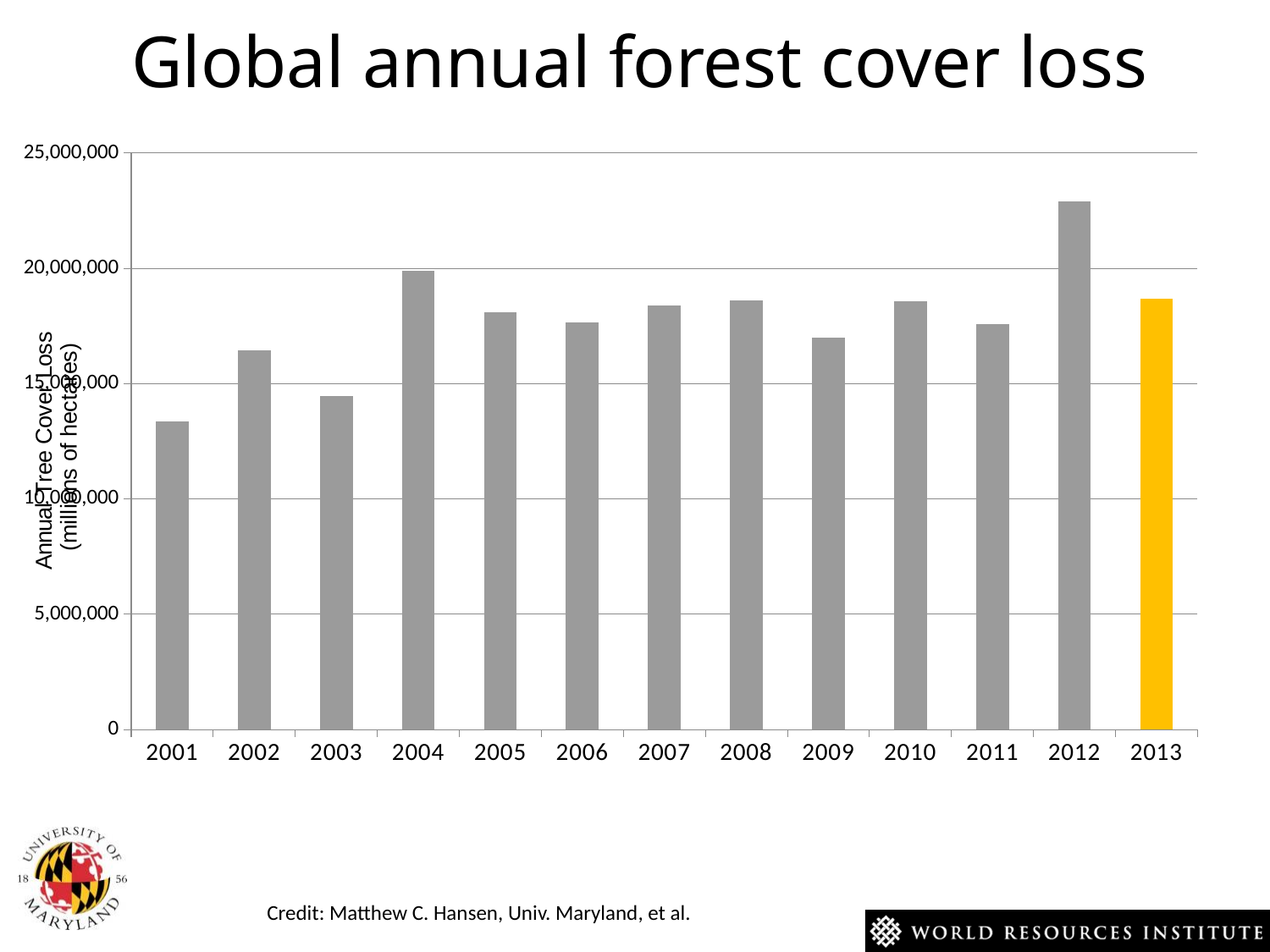
Which year has the lowest annual tree cover loss? 2001 Is the value for 2003 greater or less than 15,000,000? less Does the annual tree cover loss rise or fall from 2001 to 2002? rise Which year has the highest annual tree cover loss? 2012 Which year's bar is coloured differently (yellow) from the others? 2013 Is the value for 2004 greater or less than 15,000,000? greater Which year has the larger annual tree cover loss, 2003 or 2004? 2004 Is the value for 2012 greater or less than 20,000,000? greater How many years are shown on the x axis of the chart? 13 What kind of chart is shown on the slide? bar chart Which year has the larger annual tree cover loss, 2009 or 2012? 2012